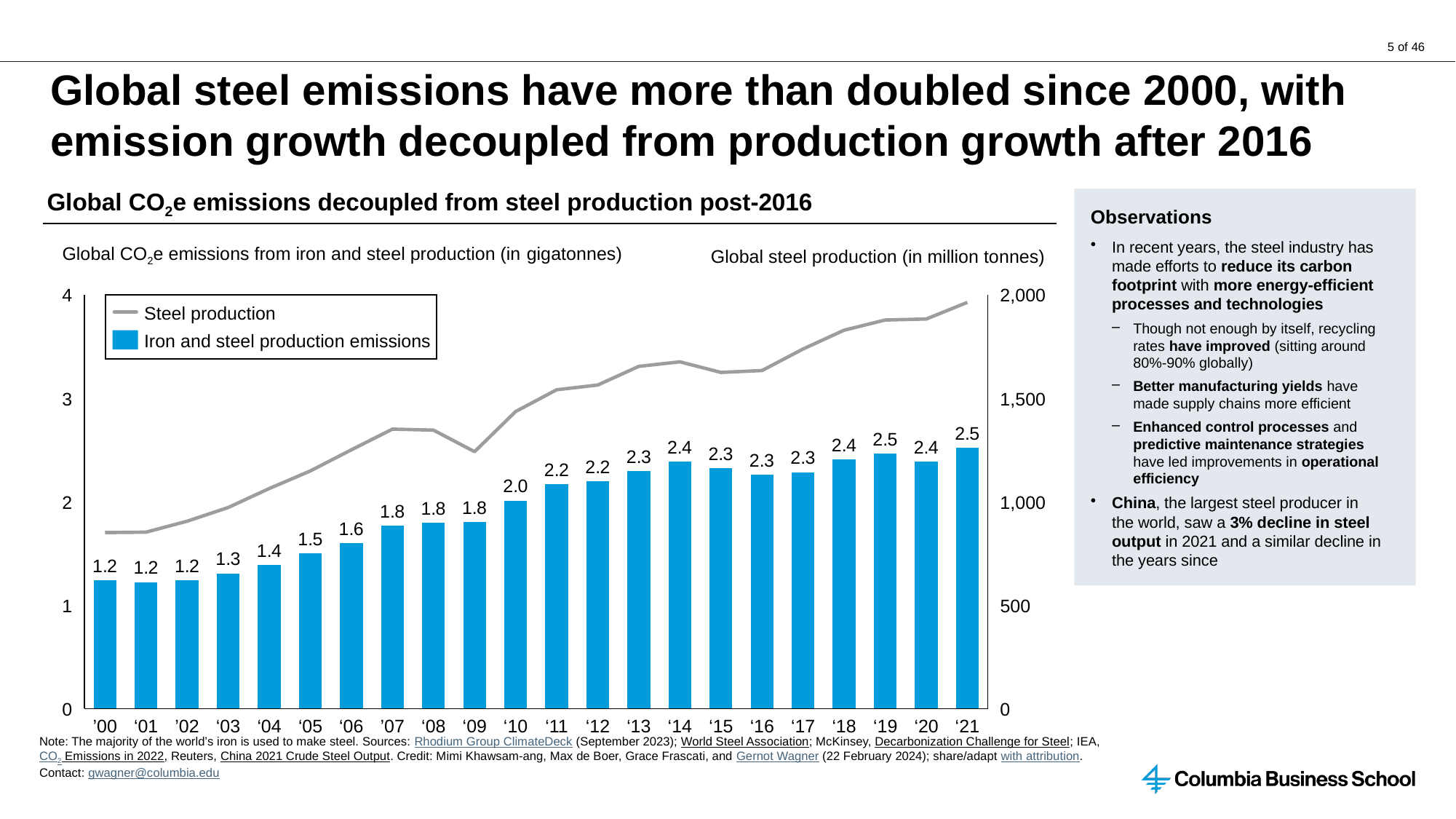
How many series does the legend list? 2 Do iron and steel production emissions generally rise or fall from '00 to '21? rise Which year has higher iron and steel production emissions, '14 or '15? '14 What is the value of iron and steel production emissions for '05? 1.5 What is the highest labelled value of iron and steel production emissions shown on the chart? 2.5 What is the value of iron and steel production emissions for '21? 2.5 What is the value of iron and steel production emissions for '10? 2.0 What is the difference between iron and steel production emissions in '21 and in '00? 1.3 Is the steel production value for '21 greater or less than 1,500? greater How many years are shown on the x axis of the chart? 22 What is the lowest labelled value of iron and steel production emissions shown on the chart? 1.2 Is the steel production value for '00 greater or less than 1,000? less